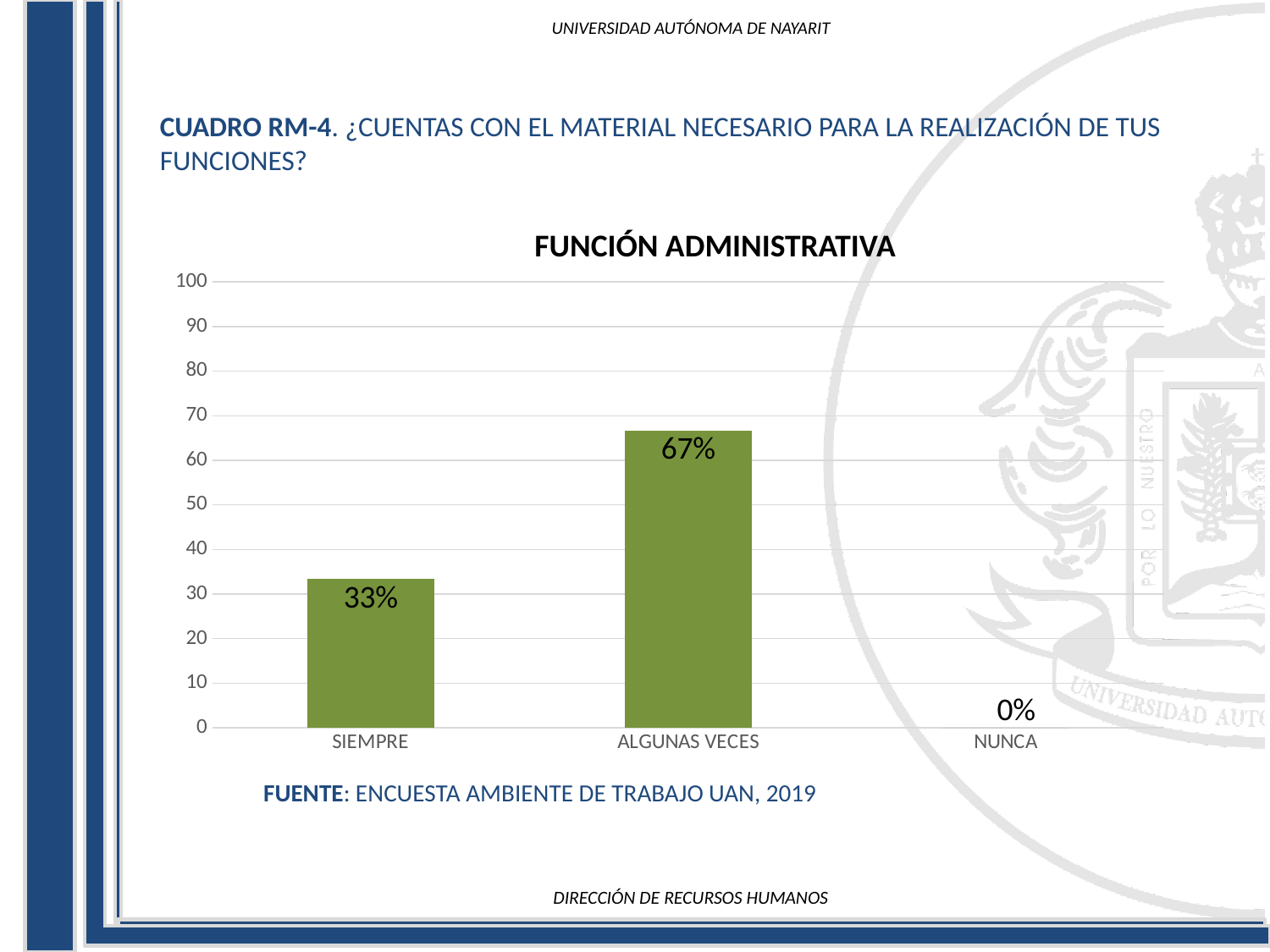
How many categories are shown on the x axis? 3 Which is larger, the value for SIEMPRE or the value for ALGUNAS VECES? ALGUNAS VECES What is the value for NUNCA? 0% What is the value for SIEMPRE? 33% Which category has the lowest value? NUNCA Which category has the highest value? ALGUNAS VECES What is the difference between the values for ALGUNAS VECES and SIEMPRE? 34% What is the title of the chart? FUNCIÓN ADMINISTRATIVA What is the value for ALGUNAS VECES? 67% Is the value for ALGUNAS VECES greater or less than 50? greater Is the value for SIEMPRE greater or less than 40? less What kind of chart is shown on the slide? bar chart